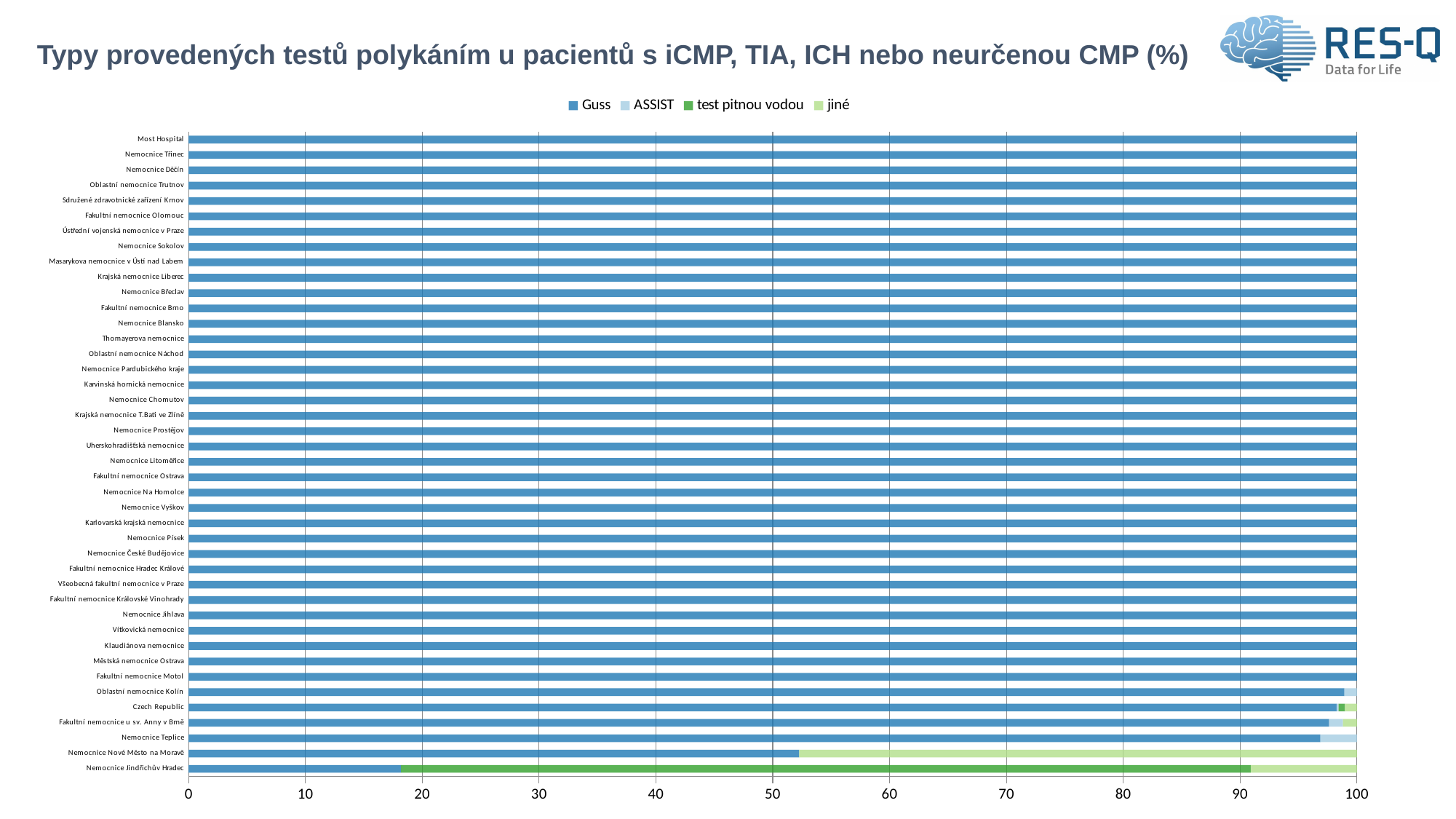
What kind of chart is shown on the slide? bar chart Is the Guss value for Nemocnice Nové Město na Moravě greater or less than 50? greater Which category has the lowest value for Guss? Nemocnice Jindřichův Hradec Is the jiné value for Nemocnice Nové Město na Moravě greater or less than 40? greater Is the test pitnou vodou value for Nemocnice Jindřichův Hradec greater or less than 60? greater What is the title of the chart? Typy provedených testů polykáním u pacientů s iCMP, TIA, ICH nebo neurčenou CMP (%) Which series are listed in the legend? Guss, ASSIST, test pitnou vodou, jiné How many hospitals/categories are plotted on the chart? 42 How many series does the legend list? 4 Which is larger, the Guss value for Nemocnice Nové Město na Moravě or for Nemocnice Jindřichův Hradec? Nemocnice Nové Město na Moravě What is the total of the stacked bar for Most Hospital? 100